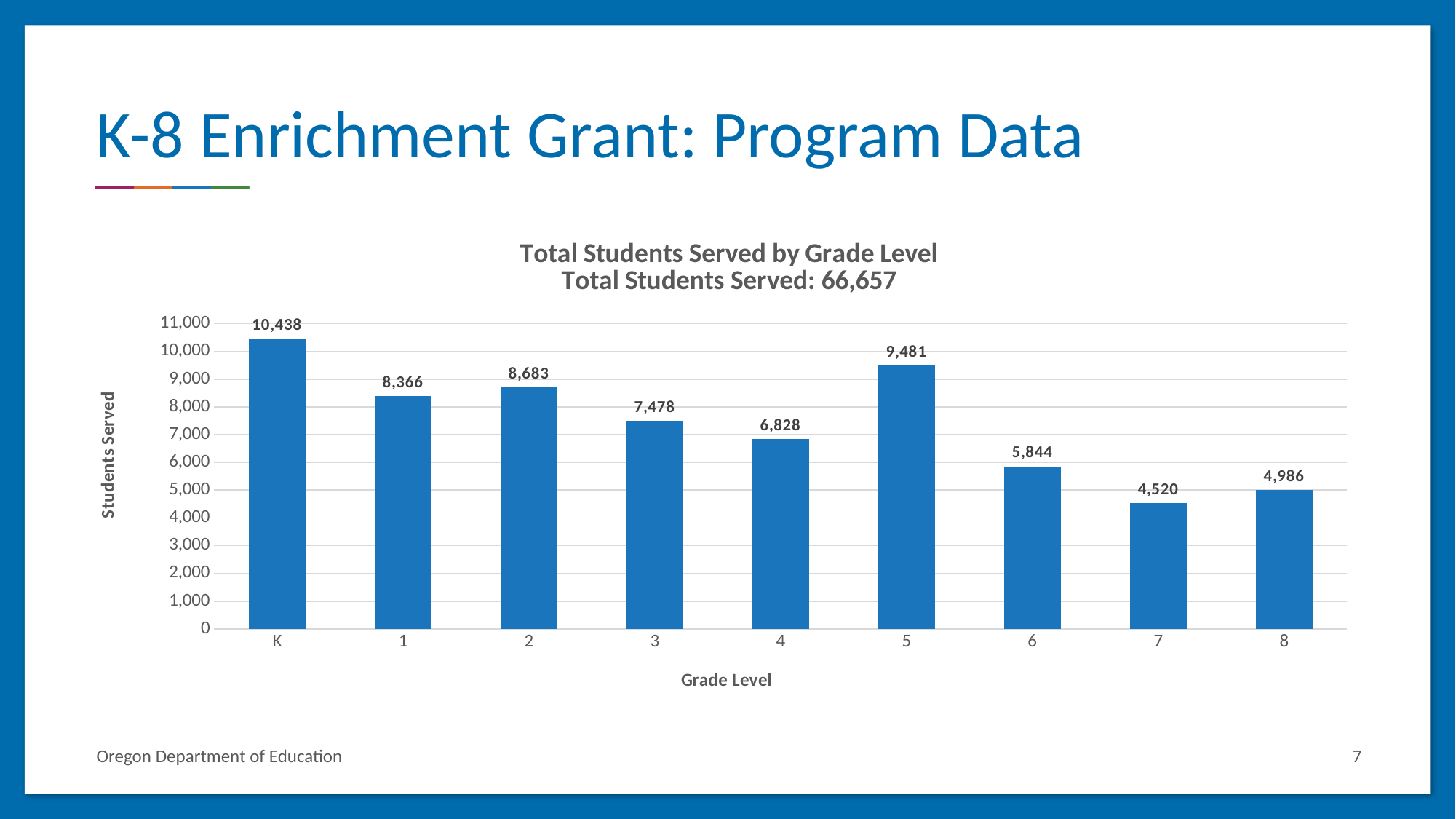
Which grade level has the highest number of students served? K What is the difference between the number of students served in grade K and grade 8? 5,452 How many students were served in grade 7? 4,520 Which grade level has the lowest number of students served? 7 What kind of chart is shown on the slide? bar chart Which grade has more students served, grade 1 or grade 2? 2 How many students were served in grade 5? 9,481 Is the value for grade 4 greater or less than 7,000? less What is the total number of students served stated in the chart title? 66,657 What is the label of the y axis? Students Served How many grade levels are shown on the x axis? 9 How many students were served in grade K? 10,438